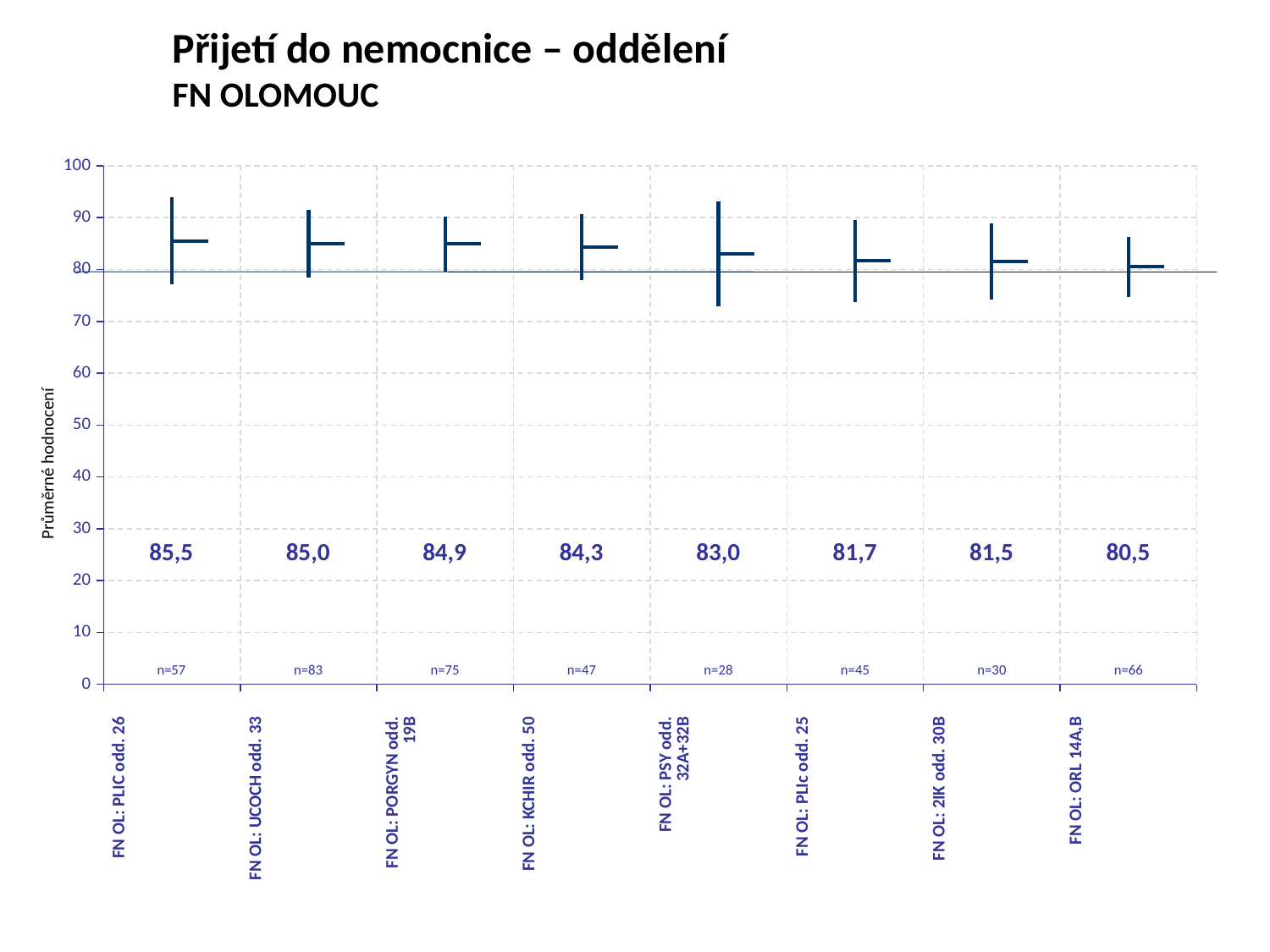
What is the average rating for FN OL: PSY odd. 32A+32B? 83,0 Which department has the lowest average rating? FN OL: ORL 14A,B How many departments are shown on the chart? 8 Is the average rating for FN OL: 2IK odd. 30B greater or less than 80? greater What is the average rating (průměrné hodnocení) for FN OL: PLIC odd. 26? 85,5 Which department has the highest average rating? FN OL: PLIC odd. 26 What is the average rating for FN OL: ORL 14A,B? 80,5 What is the label of the vertical axis? Průměrné hodnocení Do the average ratings rise or fall from left to right along the x axis? fall Which has a higher average rating: FN OL: KCHIR odd. 50 or FN OL: PLIc odd. 25? FN OL: KCHIR odd. 50 What is the difference between the average ratings of FN OL: PLIC odd. 26 and FN OL: ORL 14A,B? 5,0 What is the sample size (n) shown for FN OL: UCOCH odd. 33? n=83